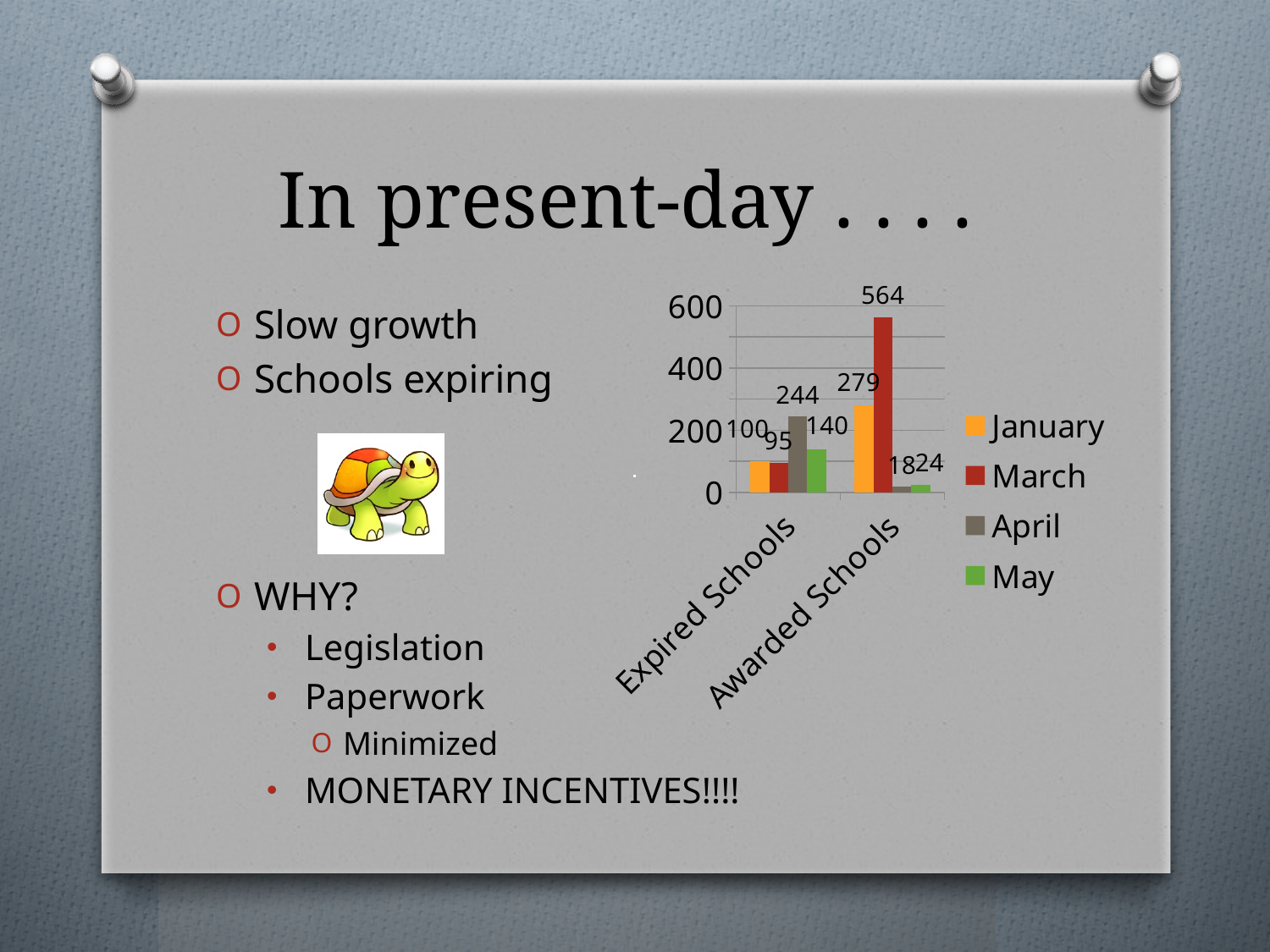
What is the difference between the March and January values in the Awarded Schools category? 285 Which month has the highest value in the Awarded Schools category? March What is the value for March in the Expired Schools category? 95 What is the value for March in the Awarded Schools category? 564 In the Expired Schools category, which is larger: the value for May or the value for January? May What is the value for April in the Expired Schools category? 244 What colour represents March in the chart's legend? red Which month has the highest value in the Expired Schools category? April What kind of chart is shown on the slide? bar chart How many categories are shown on the x axis of the chart? 2 How many series does the chart's legend list? 4 What is the value for January in the Awarded Schools category? 279